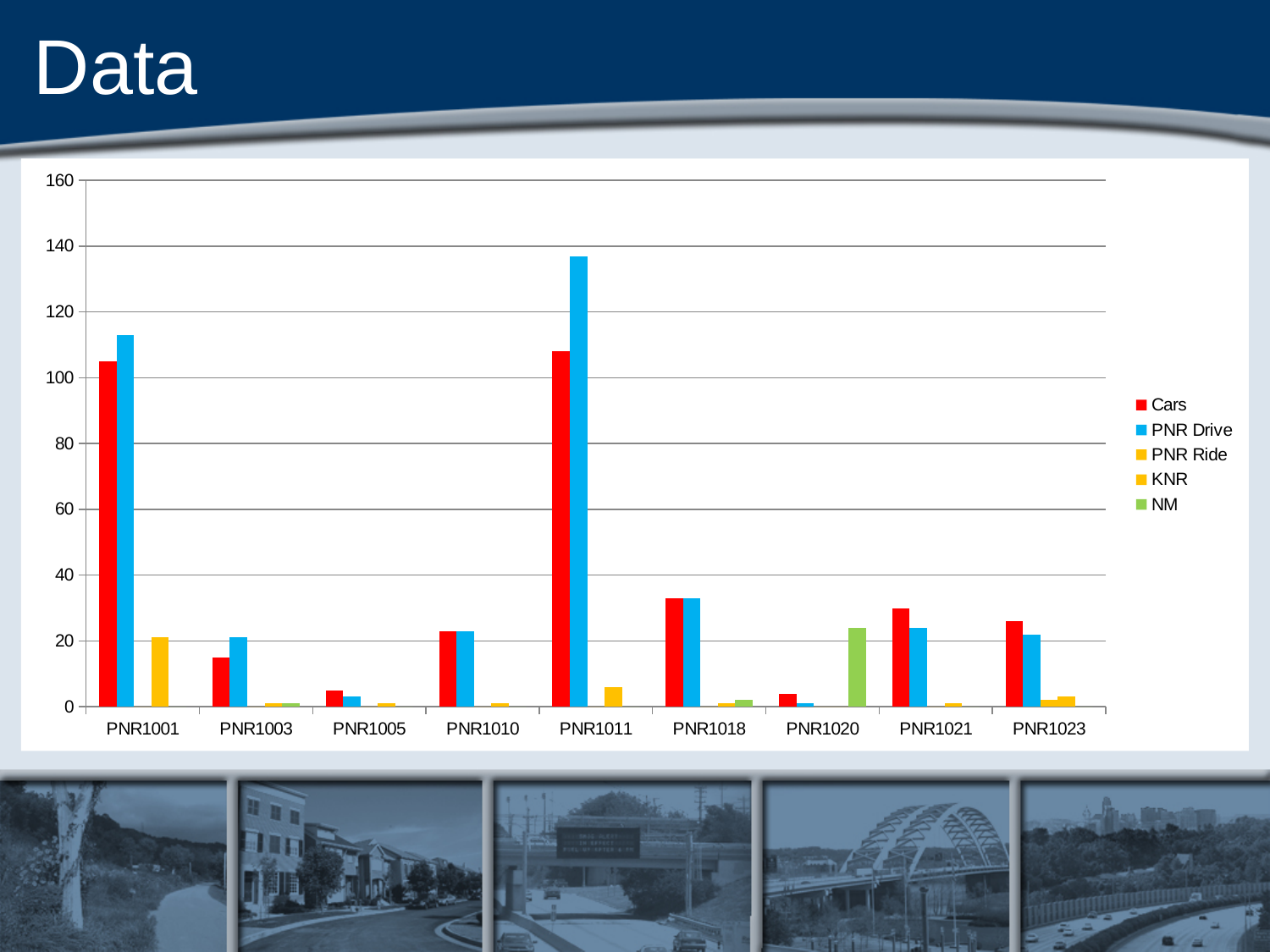
Is the Cars value for PNR1018 greater or less than 40? less Is the Cars value for PNR1003 greater or less than 20? less How many series does the legend list? 5 For PNR1020, which is larger: Cars or NM? NM What kind of chart is shown on the slide? bar chart For PNR1011, which is larger: Cars or PNR Drive? PNR Drive Which category has the highest PNR Drive value? PNR1011 Is the Cars value for PNR1001 greater or less than 100? greater Which series is shown in green in the legend? NM How many categories are shown along the x axis? 9 Which category has the highest Cars value? PNR1011